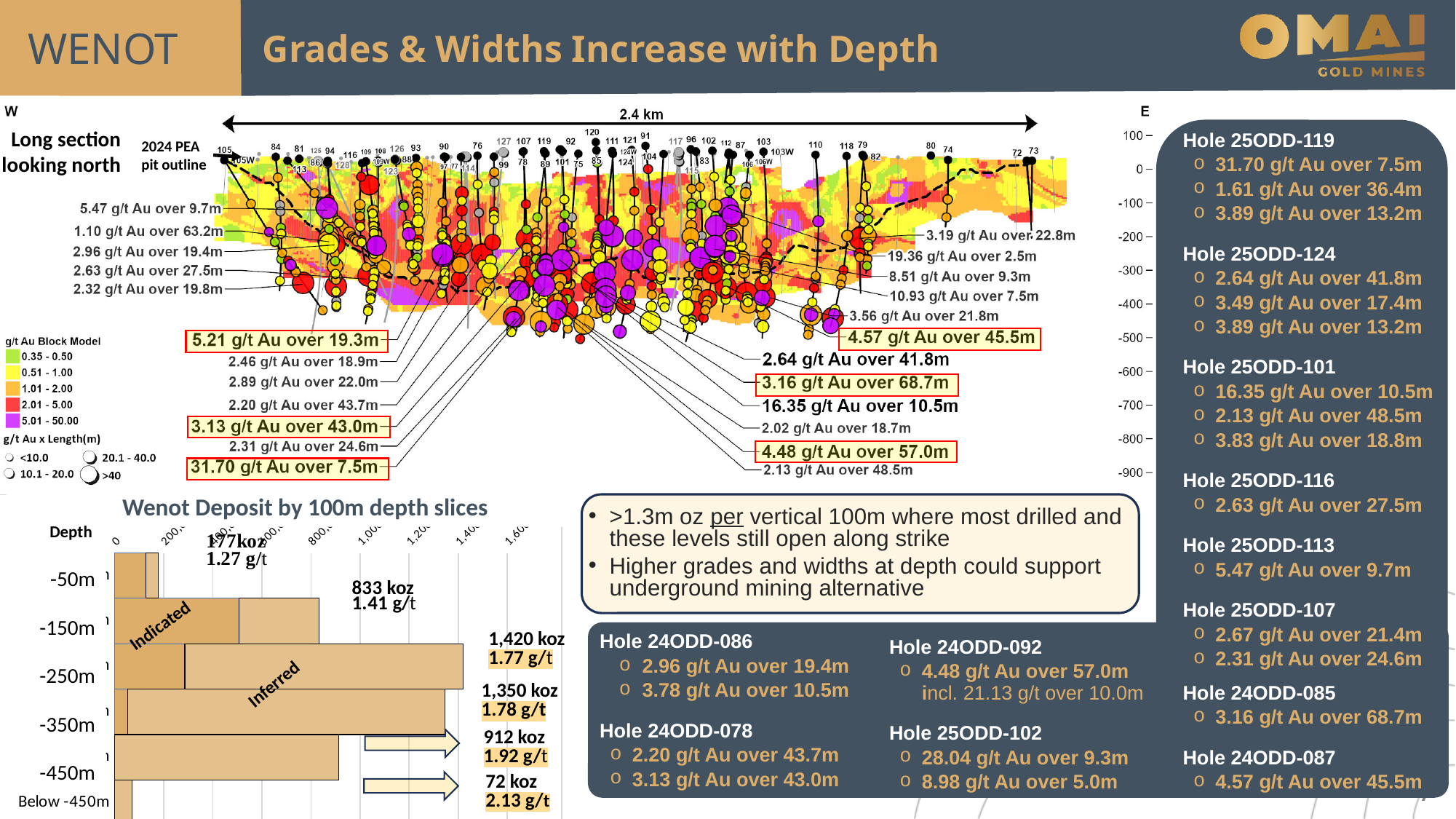
In the 'Wenot Deposit by 100m depth slices' chart, which depth slice has the highest labelled grade? Below -450m In the 'Wenot Deposit by 100m depth slices' chart, which depth slice has the lowest koz? Below -450m How many depth slices are shown in the 'Wenot Deposit by 100m depth slices' chart? 6 What kind of chart is 'Wenot Deposit by 100m depth slices'? bar chart In the 'Wenot Deposit by 100m depth slices' chart, which has more koz: the -150m slice or the -450m slice? -450m What two resource categories are labelled on the bars of the 'Wenot Deposit by 100m depth slices' chart? Indicated and Inferred In the 'Wenot Deposit by 100m depth slices' chart, what grade is labelled for the -450m slice? 1.92 g/t In the 'Wenot Deposit by 100m depth slices' chart, do the labelled grades rise or fall as depth increases from -50m to Below -450m? rise In the 'Wenot Deposit by 100m depth slices' chart, which depth slice has the highest koz? -250m In the 'Wenot Deposit by 100m depth slices' chart, how many koz are labelled for the -50m slice? 177 koz In the 'Wenot Deposit by 100m depth slices' chart, how many koz are labelled for the -250m slice? 1,420 koz In the 'Wenot Deposit by 100m depth slices' chart, what is the difference in koz between the -250m and -350m slices? 70 koz